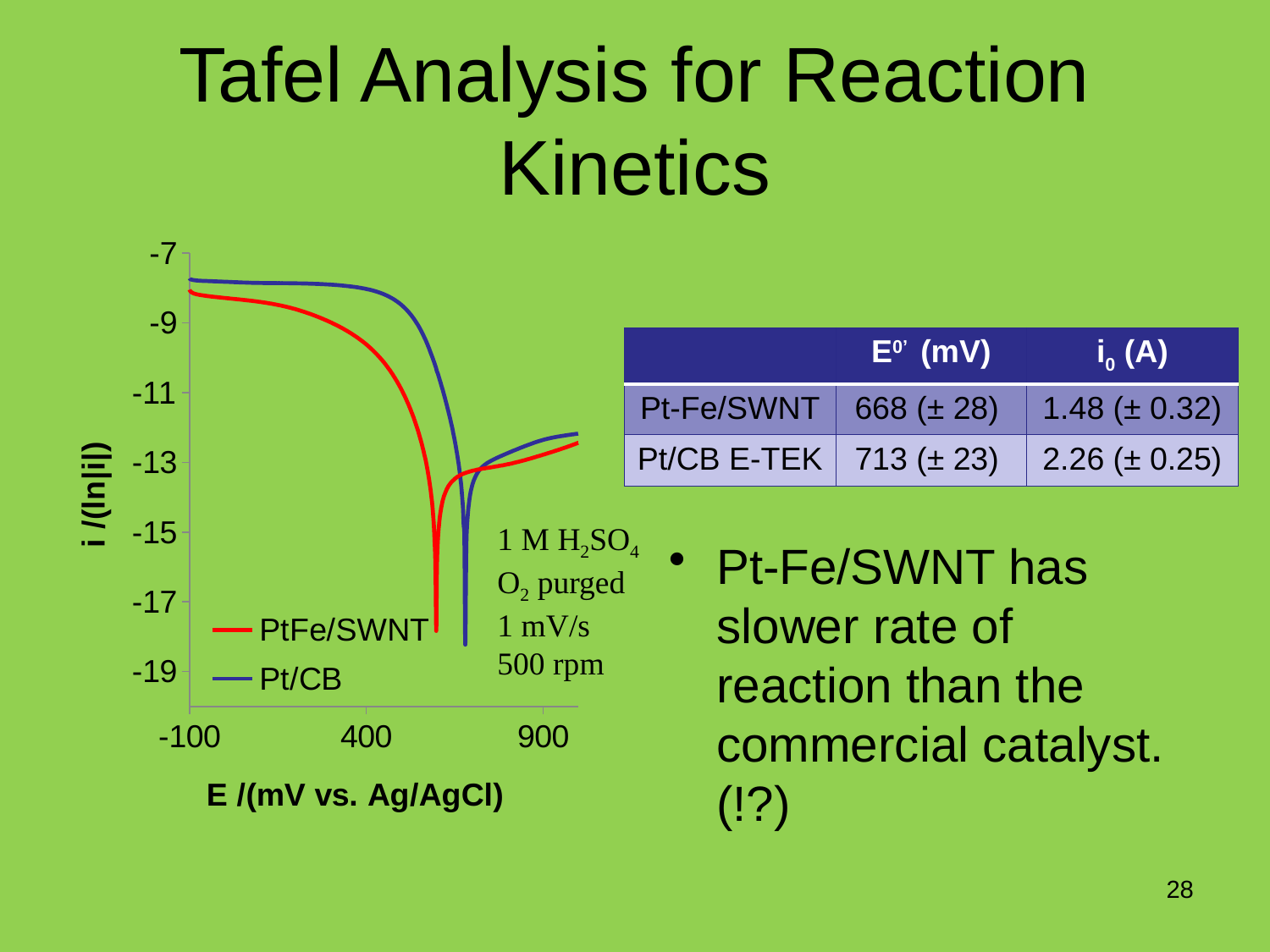
What are the two series named in the chart legend? PtFe/SWNT and Pt/CB At 900 mV, is the value of the Pt/CB curve greater or less than -13? greater Between -100 mV and about 600 mV, does the PtFe/SWNT curve rise or fall? fall Is the lowest point of the PtFe/SWNT curve greater or less than -17? less How many series does the chart legend list? 2 At -100 mV, is the value of the PtFe/SWNT curve greater or less than -9? greater What is the label of the chart's x axis? E /(mV vs. Ag/AgCl) Which series reaches its minimum at a lower potential (further left on the x axis), PtFe/SWNT or Pt/CB? PtFe/SWNT After its minimum, does the Pt/CB curve rise or fall as the potential increases toward 900 mV? rise What kind of chart is shown on the slide? line chart